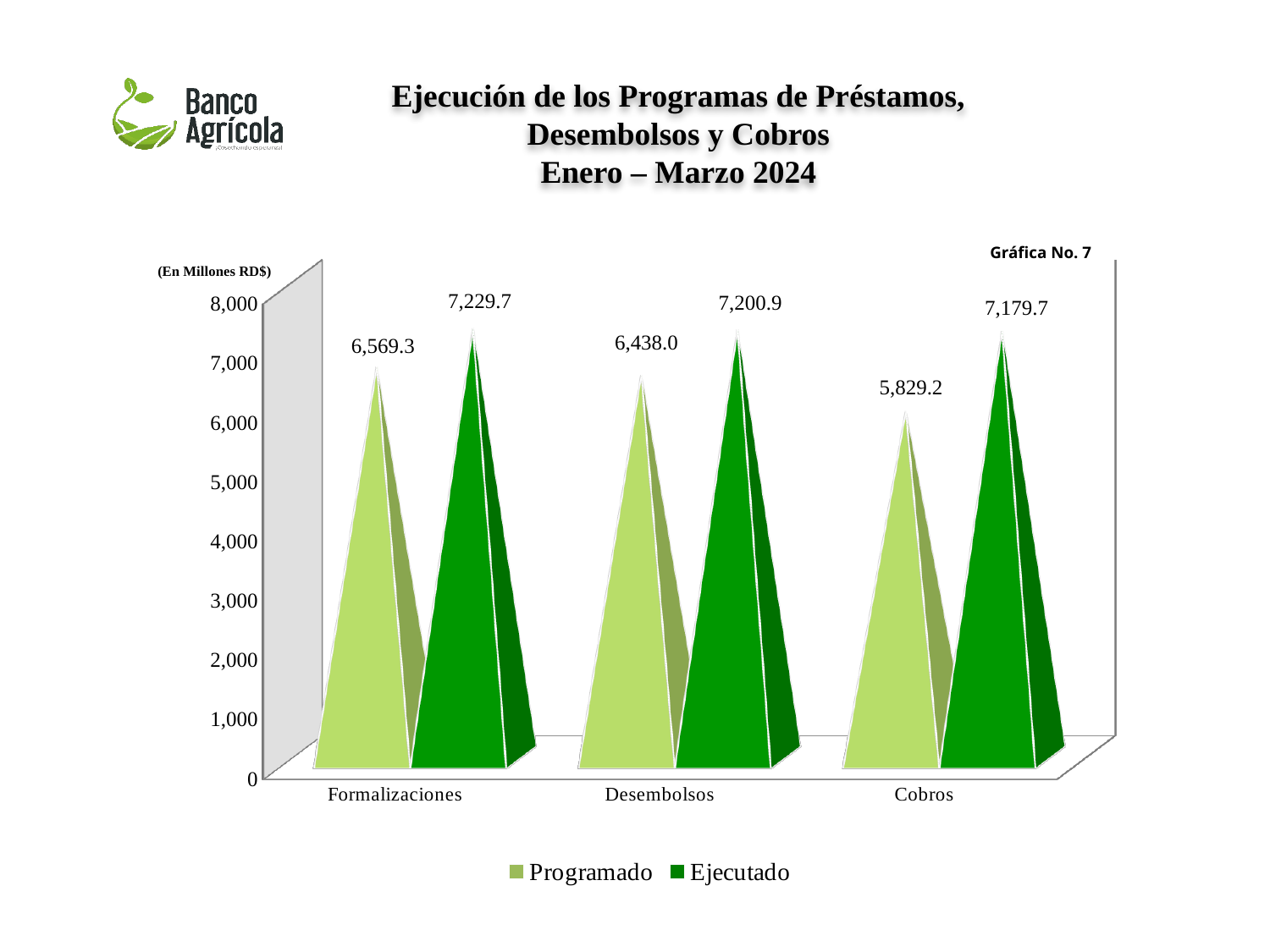
How many series does the legend list? 2 Which category has the highest Ejecutado value? Formalizaciones What is the Ejecutado value for Desembolsos? 7,200.9 Which category has the lowest Programado value? Cobros What is the difference between the Ejecutado and Programado values for Formalizaciones? 660.4 How many categories are shown on the x axis? 3 What is the Ejecutado value for Cobros? 7,179.7 What is the Programado value for Cobros? 5,829.2 Which is larger for Desembolsos, the Programado value or the Ejecutado value? Ejecutado What is the difference between the Ejecutado and Programado values for Cobros? 1,350.5 What unit is stated for the values in the chart? En Millones RD$ What is the Programado value for Formalizaciones? 6,569.3